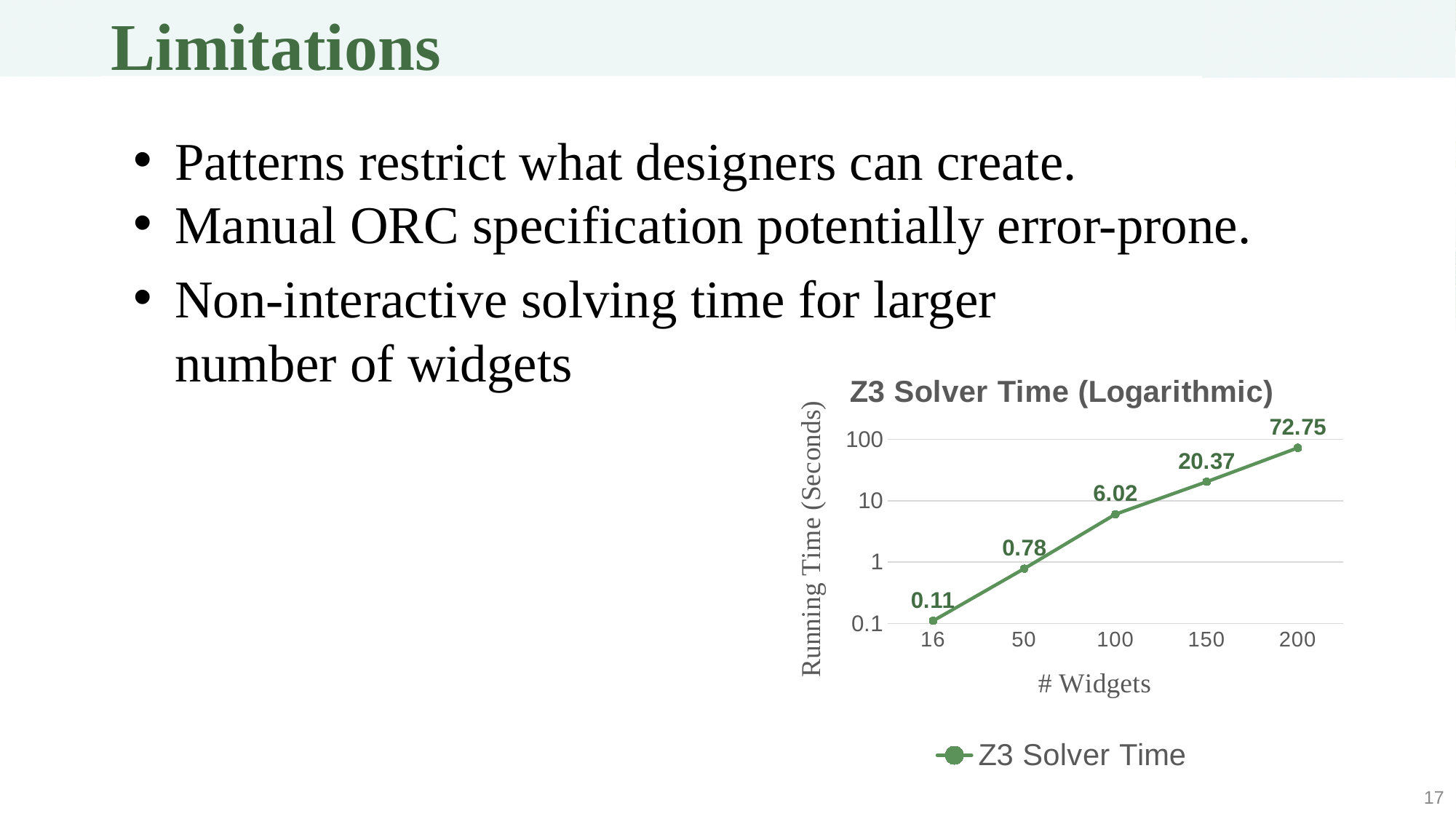
Is the Z3 solver time for 150 widgets greater or less than 10? greater How many data points are plotted in the chart? 5 What is the Z3 solver time for 16 widgets? 0.11 How many series does the legend list? 1 Does the Z3 solver time rise or fall as the number of widgets increases? rise What is the difference between the Z3 solver time for 200 widgets and for 150 widgets? 52.38 What kind of chart is shown on the slide? line chart Which number of widgets has the lowest Z3 solver time? 16 What is the Z3 solver time for 100 widgets? 6.02 Which number of widgets has the highest Z3 solver time? 200 What is the Z3 solver time for 200 widgets? 72.75 Which has a larger Z3 solver time, 50 widgets or 100 widgets? 100 widgets